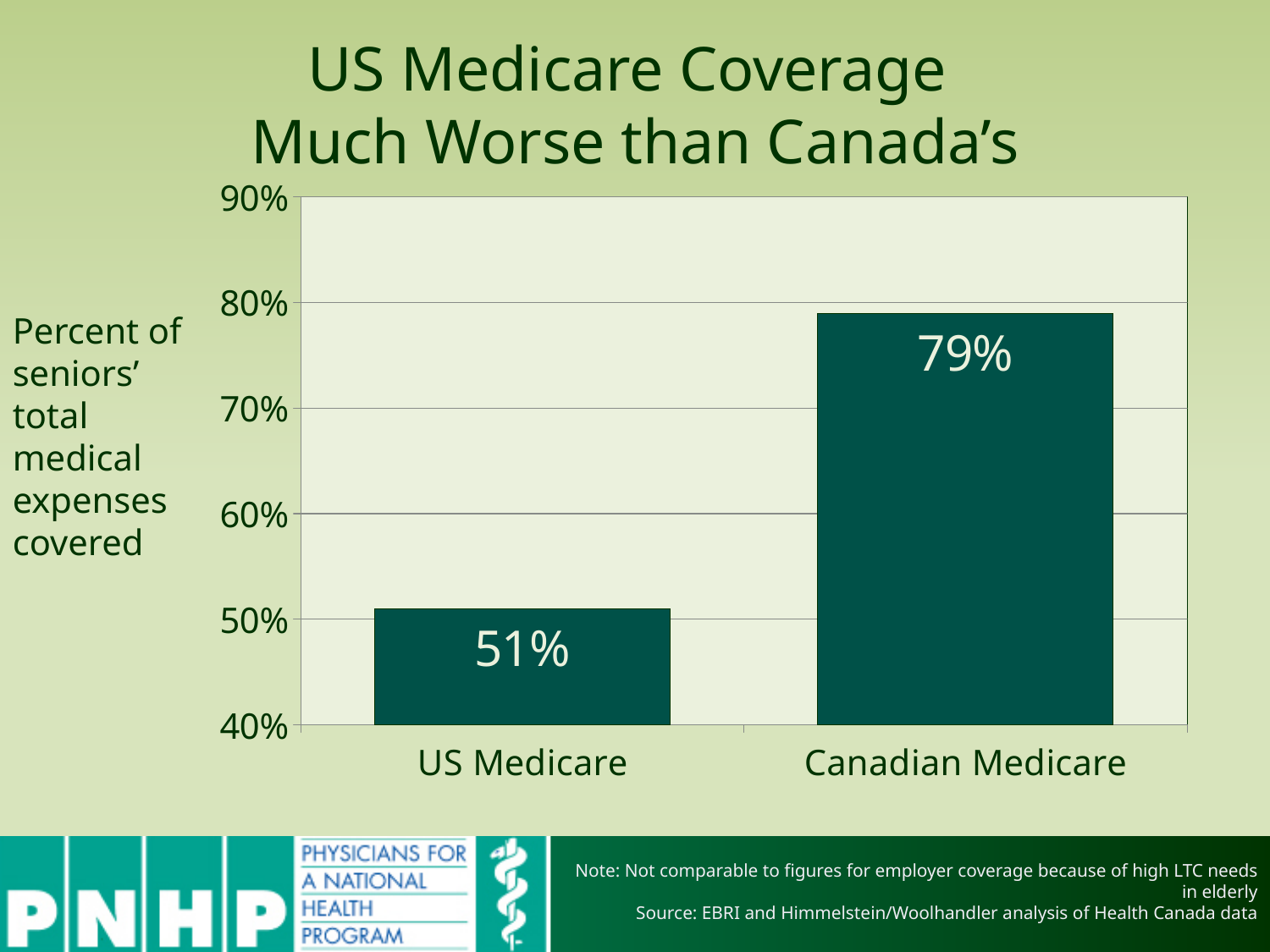
What percent of seniors' total medical expenses does US Medicare cover? 51% What kind of chart is shown on the slide? bar chart How many categories are shown on the chart? 2 What is the title of the slide? US Medicare Coverage Much Worse than Canada's What is the lowest value shown on the vertical axis? 40% Which category has the lowest value on the chart? US Medicare Is the value for Canadian Medicare greater or less than 70%? greater Is the value for US Medicare larger or smaller than the value for Canadian Medicare? smaller Is the value for US Medicare greater or less than 60%? less What percent of seniors' total medical expenses does Canadian Medicare cover? 79% Which category has the higher value, US Medicare or Canadian Medicare? Canadian Medicare What is the difference in percentage points between Canadian Medicare and US Medicare? 28